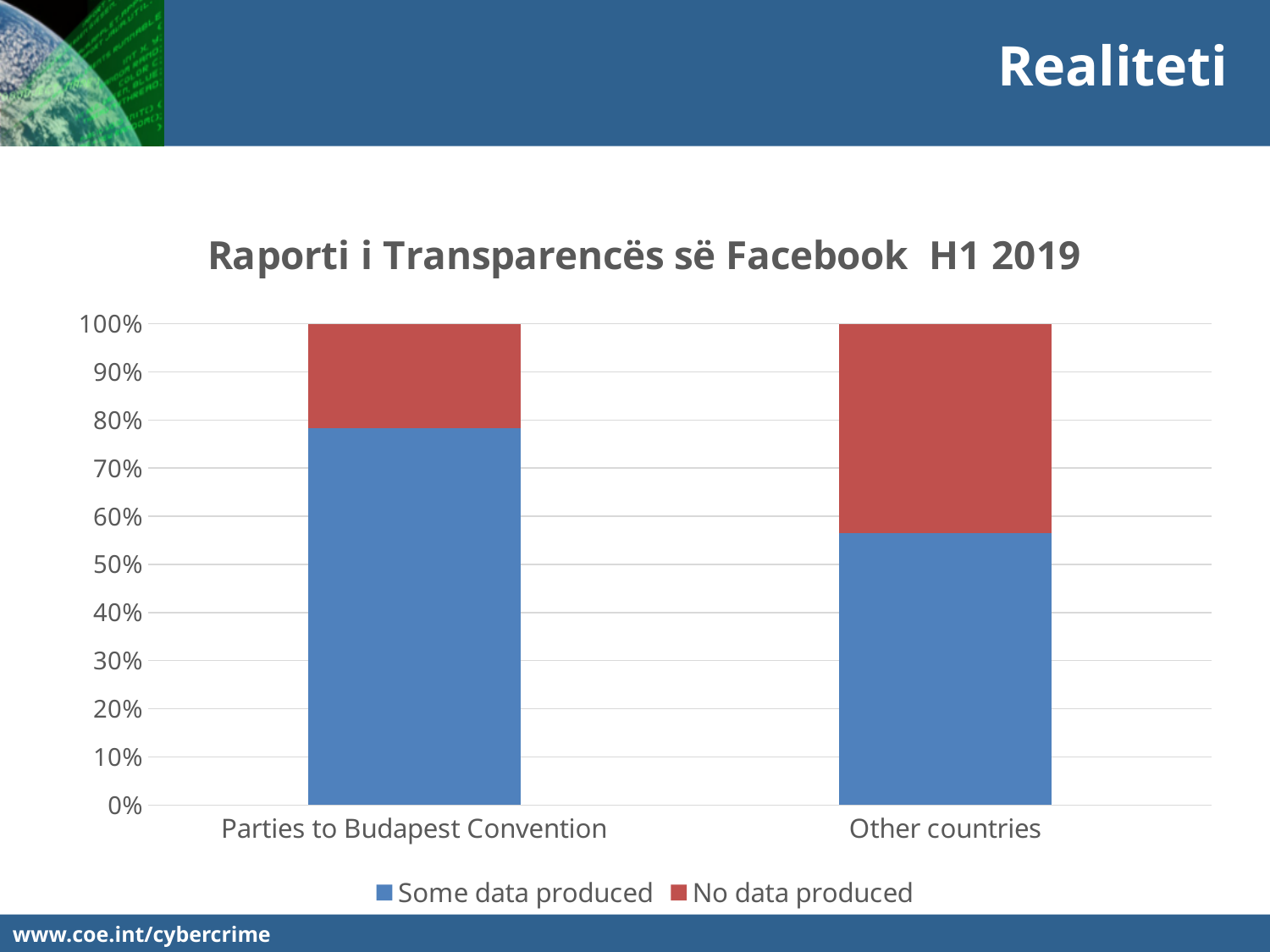
What is the title of the chart? Raporti i Transparencës së Facebook H1 2019 What kind of chart is shown on the slide? Stacked bar chart How many categories are shown on the x axis? 2 Is the value for Some data produced for Parties to Budapest Convention greater or less than 80%? less Which category has the lowest share of Some data produced? Other countries Which category has the higher share of Some data produced? Parties to Budapest Convention Is the value for Some data produced for Parties to Budapest Convention greater or less than 70%? greater Which series is shown in blue? Some data produced How many series does the legend list? 2 Is the value for Some data produced for Other countries greater or less than 60%? less Which category has the larger share of No data produced? Other countries What is the total height of the stacked bar for Other countries? 100%